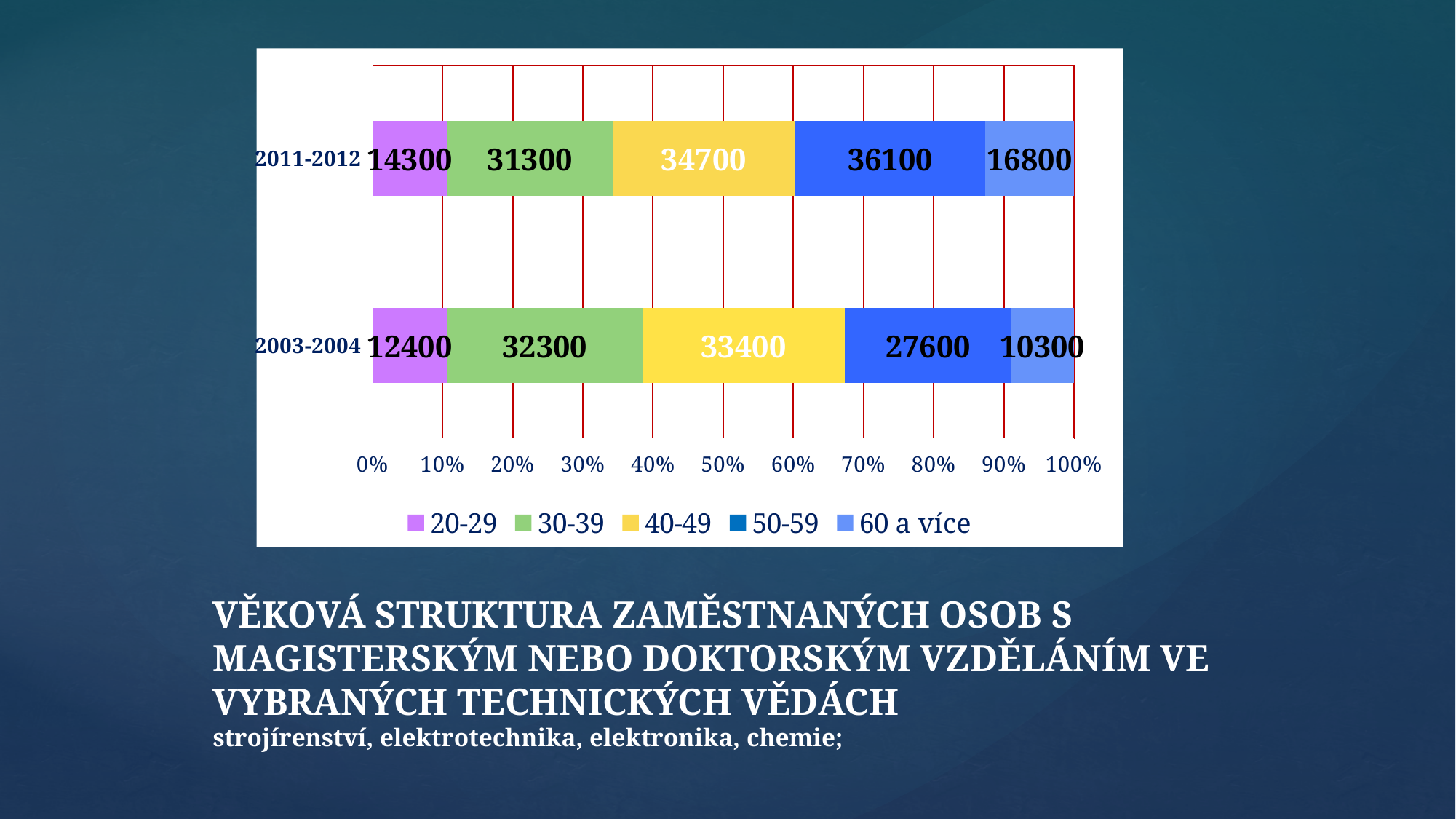
What is the difference between the 50-59 values for 2011-2012 and 2003-2004? 8500 How many categories (time periods) are shown on the chart? 2 How many series does the legend list? 5 Which is larger, the 30-39 value in 2003-2004 or the 30-39 value in 2011-2012? 2003-2004 What kind of chart is shown on the slide? Stacked bar chart What is the value for the 20-29 age group in 2003-2004? 12400 Which age group has the lowest value in 2003-2004? 60 a více What is the value for the 50-59 age group in 2011-2012? 36100 What is the total of the stacked bar for 2003-2004? 116000 What is the value for the 60 a více age group in 2011-2012? 16800 What is the total of the stacked bar for 2011-2012? 133200 Which age group has the highest value in 2011-2012? 50-59